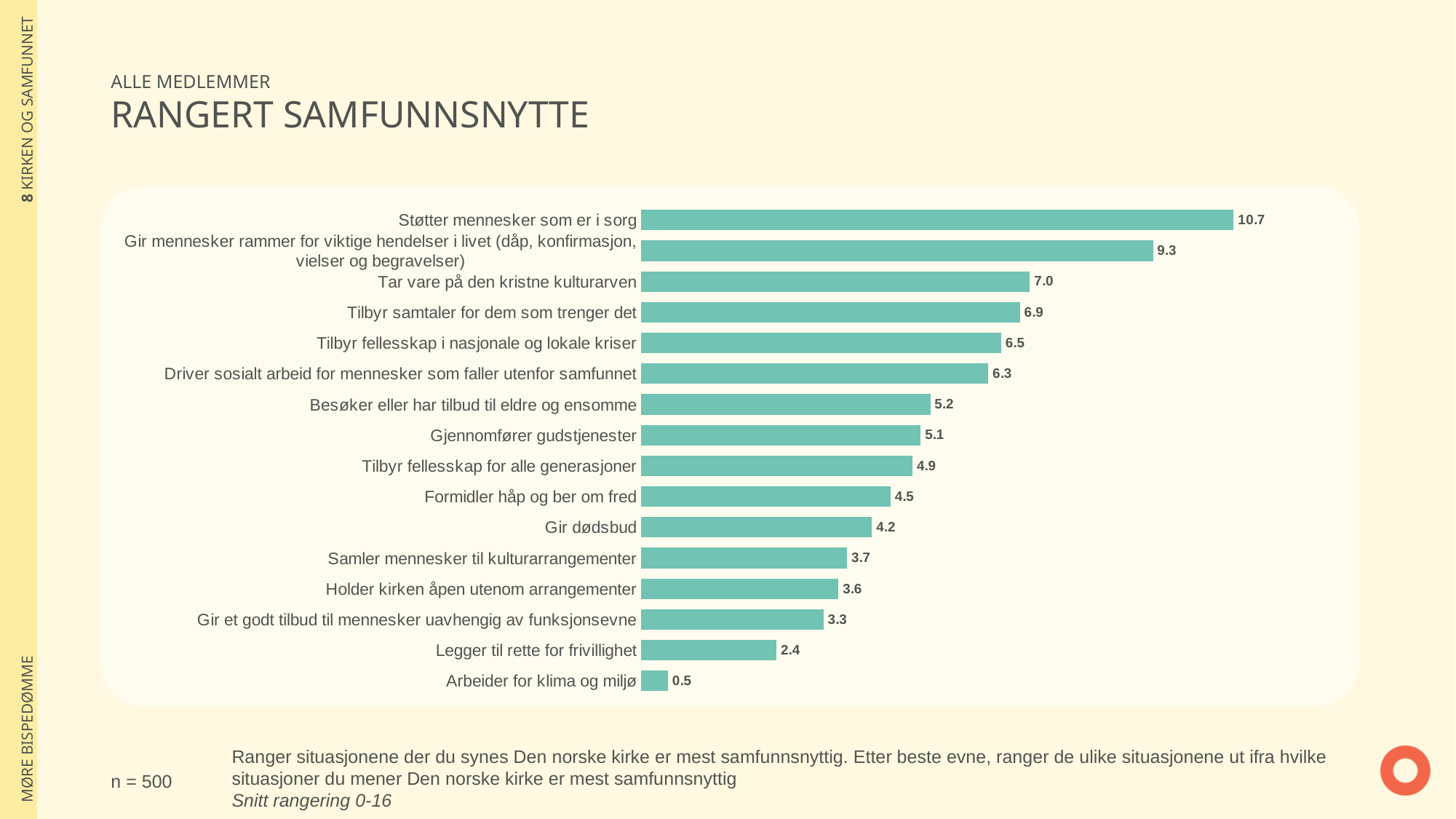
Which category has the lowest value? Arbeider for klima og miljø What is the value for "Støtter mennesker som er i sorg"? 10.7 Which category has the highest value? Støtter mennesker som er i sorg What is the value for "Legger til rette for frivillighet"? 2.4 What is the title of the slide? RANGERT SAMFUNNSNYTTE What kind of chart is shown on the slide? Bar chart Which has a larger value, "Tilbyr fellesskap i nasjonale og lokale kriser" or "Besøker eller har tilbud til eldre og ensomme"? Tilbyr fellesskap i nasjonale og lokale kriser What is the difference between the values for "Gir dødsbud" and "Arbeider for klima og miljø"? 3.7 What is the difference between the values for "Støtter mennesker som er i sorg" and "Tar vare på den kristne kulturarven"? 3.7 Which has a larger value, "Formidler håp og ber om fred" or "Samler mennesker til kulturarrangementer"? Formidler håp og ber om fred What is the value for "Gjennomfører gudstjenester"? 5.1 How many categories are shown in the chart? 16